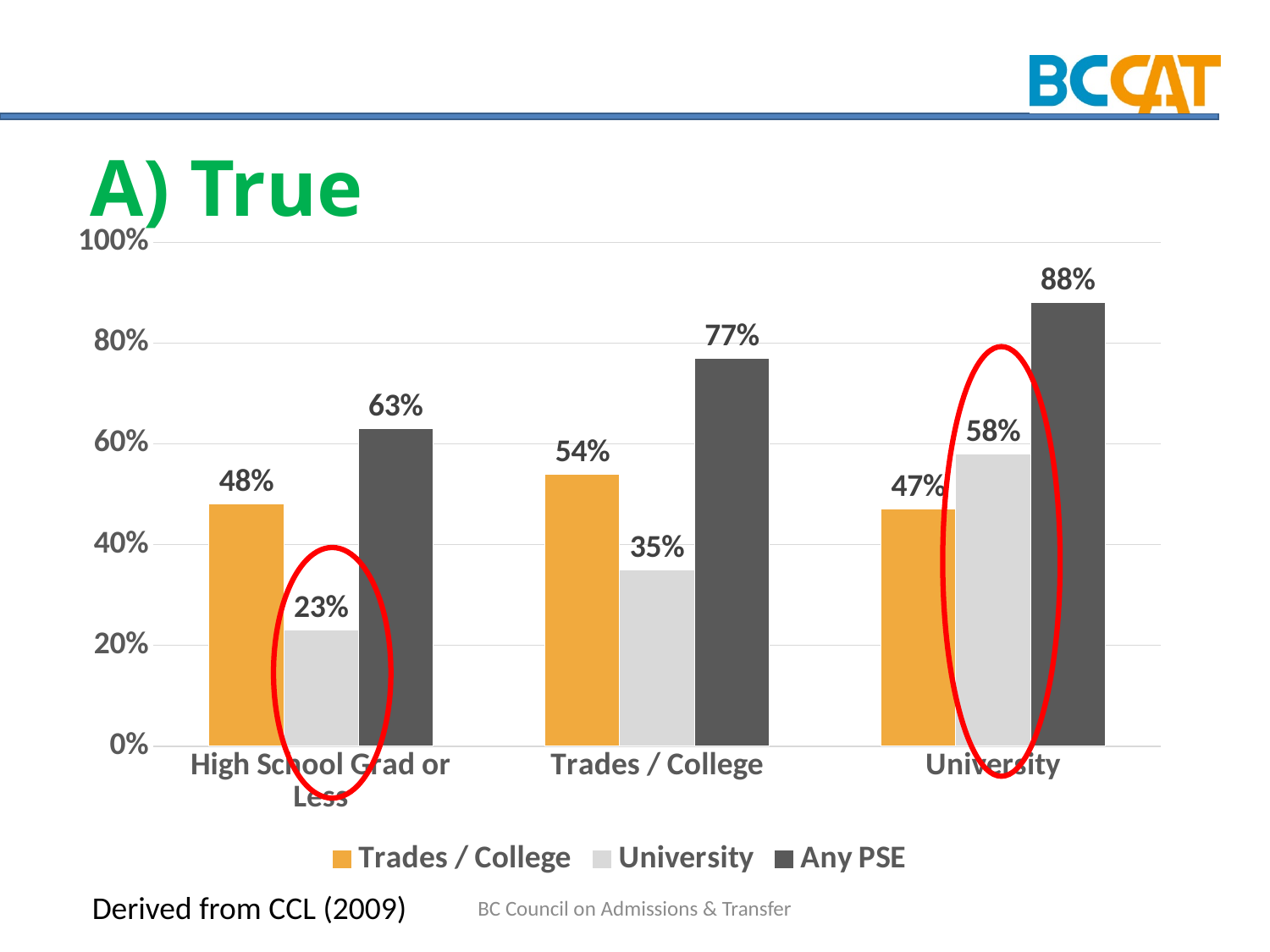
Do the Any PSE values rise or fall from High School Grad or Less to University? Rise What is the value of the Any PSE series for the Trades / College category? 77% What is the value of the Trades / College series for the University category? 47% What is the value of the University series for the High School Grad or Less category? 23% Which category has the highest Any PSE value? University How many series does the legend list? 3 How many categories are shown on the x axis? 3 Which is larger for the Trades / College category: the Trades / College series or the University series? Trades / College Which category has the lowest University series value? High School Grad or Less What is the difference between the Any PSE values for University and High School Grad or Less? 25% What kind of chart is shown on the slide? Bar chart Which series is shown in orange in the legend? Trades / College